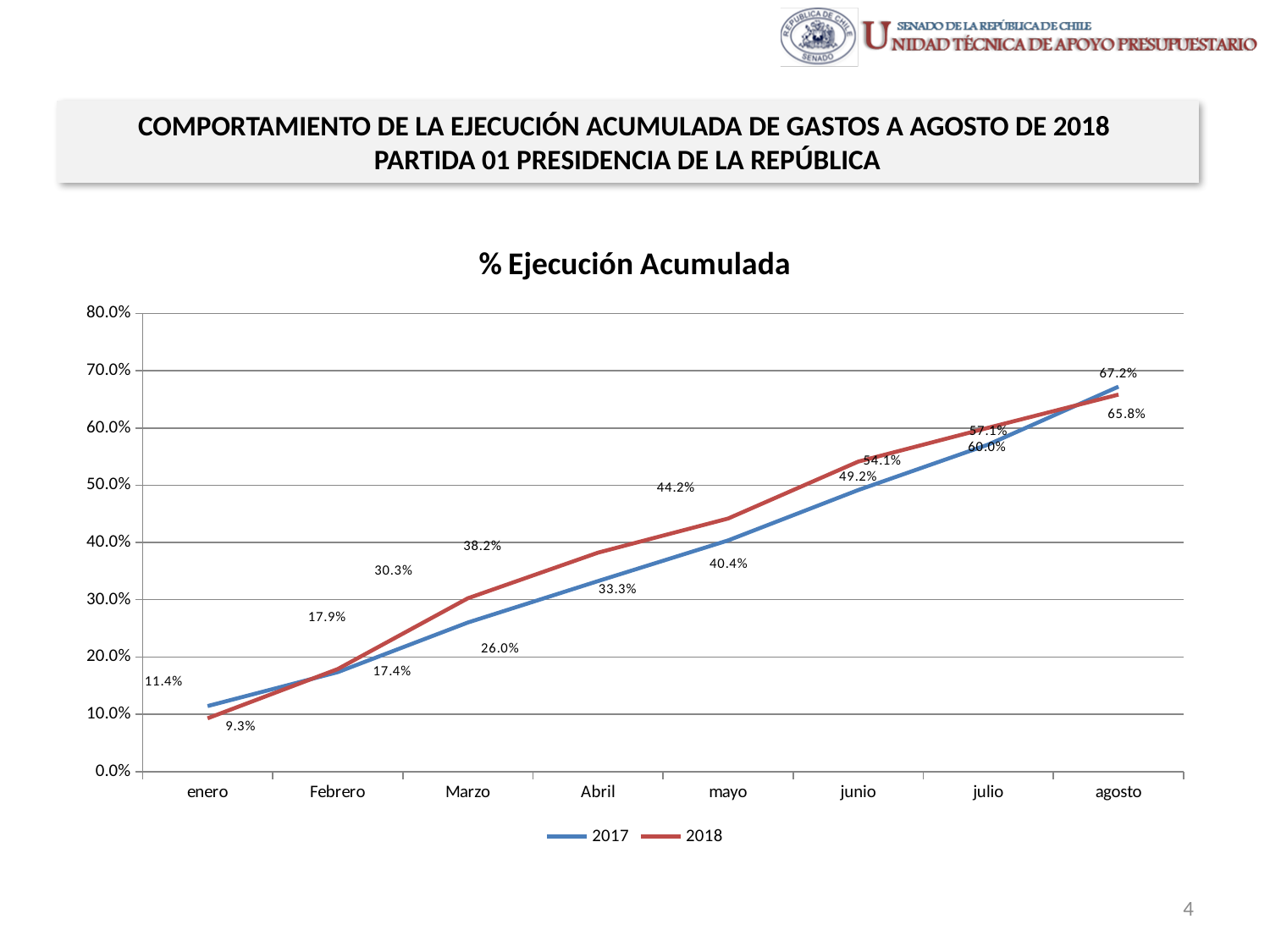
In which month does the 2017 series reach its highest value? agosto What is the value for 2018 in junio? 54.1% What is the title of the chart? % Ejecución Acumulada What kind of chart is shown on the slide? line chart Which series has the larger value in mayo, 2017 or 2018? 2018 Do the values of the 2017 series rise or fall from enero to agosto? rise What is the value for 2017 in enero? 11.4% What is the value for 2018 in Marzo? 30.3% What is the difference between the 2018 and 2017 values in Abril? 4.9 percentage points How many series does the legend list? 2 What is the lowest value of the 2018 series? 9.3% How many months are plotted along the x axis? 8